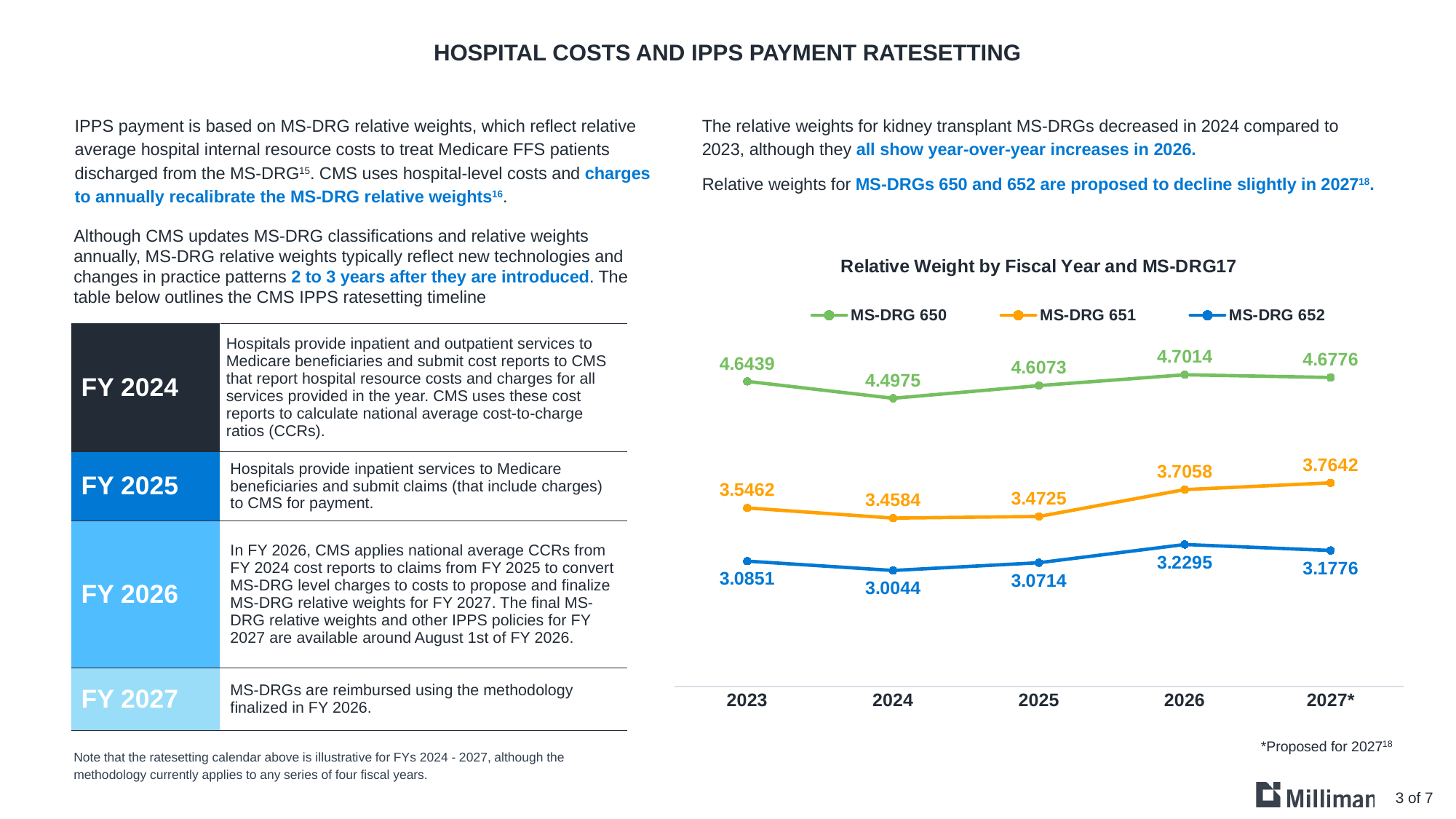
Does the relative weight for MS-DRG 651 rise or fall from 2025 to 2027*? Rise What is the relative weight for MS-DRG 651 in 2027*? 3.7642 Which is larger: the MS-DRG 651 relative weight in 2023 or in 2025? 2023 What is the difference between the MS-DRG 652 relative weight in 2026 and in 2023? 0.1444 What is the relative weight for MS-DRG 650 in 2024? 4.4975 How many series does the chart legend list? 3 What is the relative weight for MS-DRG 652 in 2023? 3.0851 What type of chart is shown on the slide? Line chart What is the difference between the MS-DRG 650 relative weight in 2026 and in 2025? 0.0941 In which fiscal year is the relative weight for MS-DRG 652 lowest? 2024 In which fiscal year is the relative weight for MS-DRG 650 highest? 2026 How many fiscal years are plotted on the x axis? 5